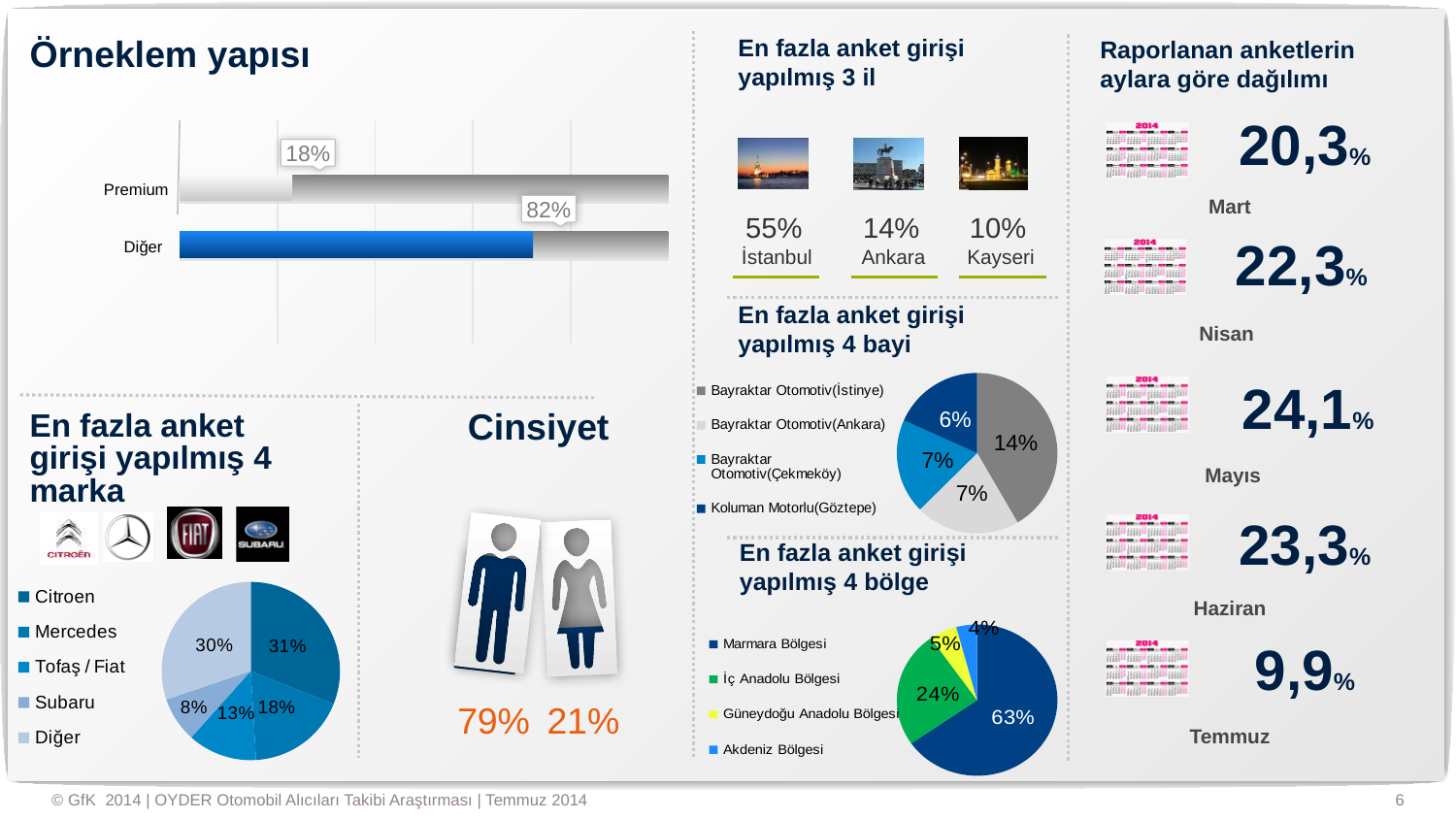
In the 'En fazla anket girişi yapılmış 4 marka' pie chart, which category has the lowest value? Subaru In the 'Örneklem yapısı' bar chart, what is the difference between the Diğer and Premium values? 64% In the 'En fazla anket girişi yapılmış 4 marka' pie chart, what share does Citroen have? 31% How many entries does the legend of the 'En fazla anket girişi yapılmış 4 marka' pie chart list? 5 In the 'Örneklem yapısı' bar chart, what is the value for Premium? 18% In the 'En fazla anket girişi yapılmış 4 bölge' pie chart, which region has the largest share? Marmara Bölgesi In the 'En fazla anket girişi yapılmış 4 marka' pie chart, what is the value for Subaru? 8% In the 'En fazla anket girişi yapılmış 4 bölge' pie chart, what is the value for Marmara Bölgesi? 63% What kind of chart is the 'Örneklem yapısı' chart? bar chart In the 'En fazla anket girişi yapılmış 4 bayi' pie chart, what is the value for Bayraktar Otomotiv (İstinye)? 14% In the 'Örneklem yapısı' bar chart, what is the value for Diğer? 82% In the 'En fazla anket girişi yapılmış 4 bölge' pie chart, what is the difference between Marmara Bölgesi and İç Anadolu Bölgesi? 39%